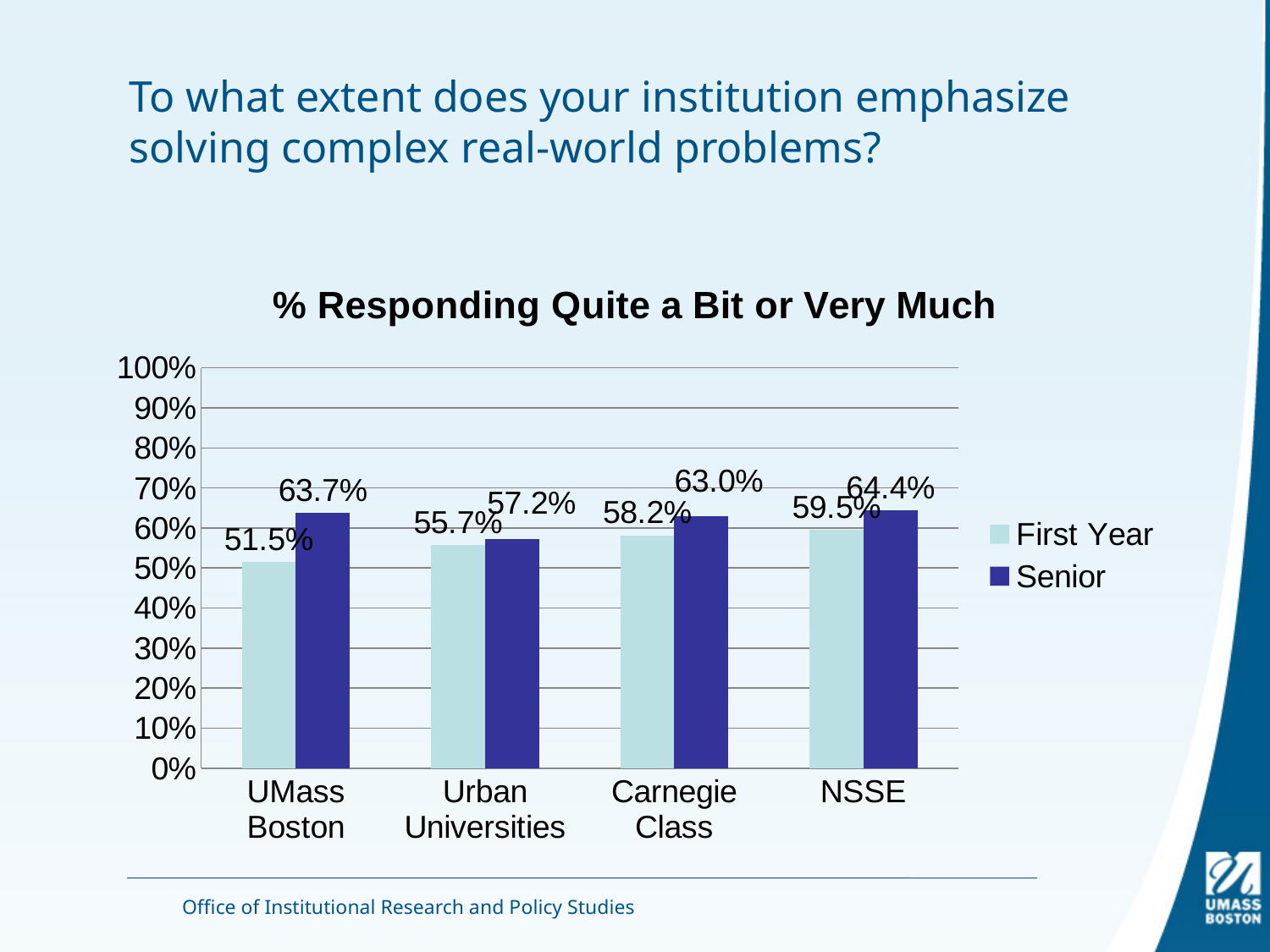
What is the Senior value for Carnegie Class? 63.0% What is the difference between the Senior and First Year values for UMass Boston? 12.2% How many series does the legend list? 2 Which is larger, the Senior value for UMass Boston or the Senior value for Urban Universities? UMass Boston What kind of chart is shown? Bar chart What is the Senior value for NSSE? 64.4% What is the title of the chart? % Responding Quite a Bit or Very Much What is the First Year value for Urban Universities? 55.7% How many categories are shown on the x axis? 4 What is the First Year value for UMass Boston? 51.5% Which category has the lowest First Year value? UMass Boston Which category has the highest Senior value? NSSE